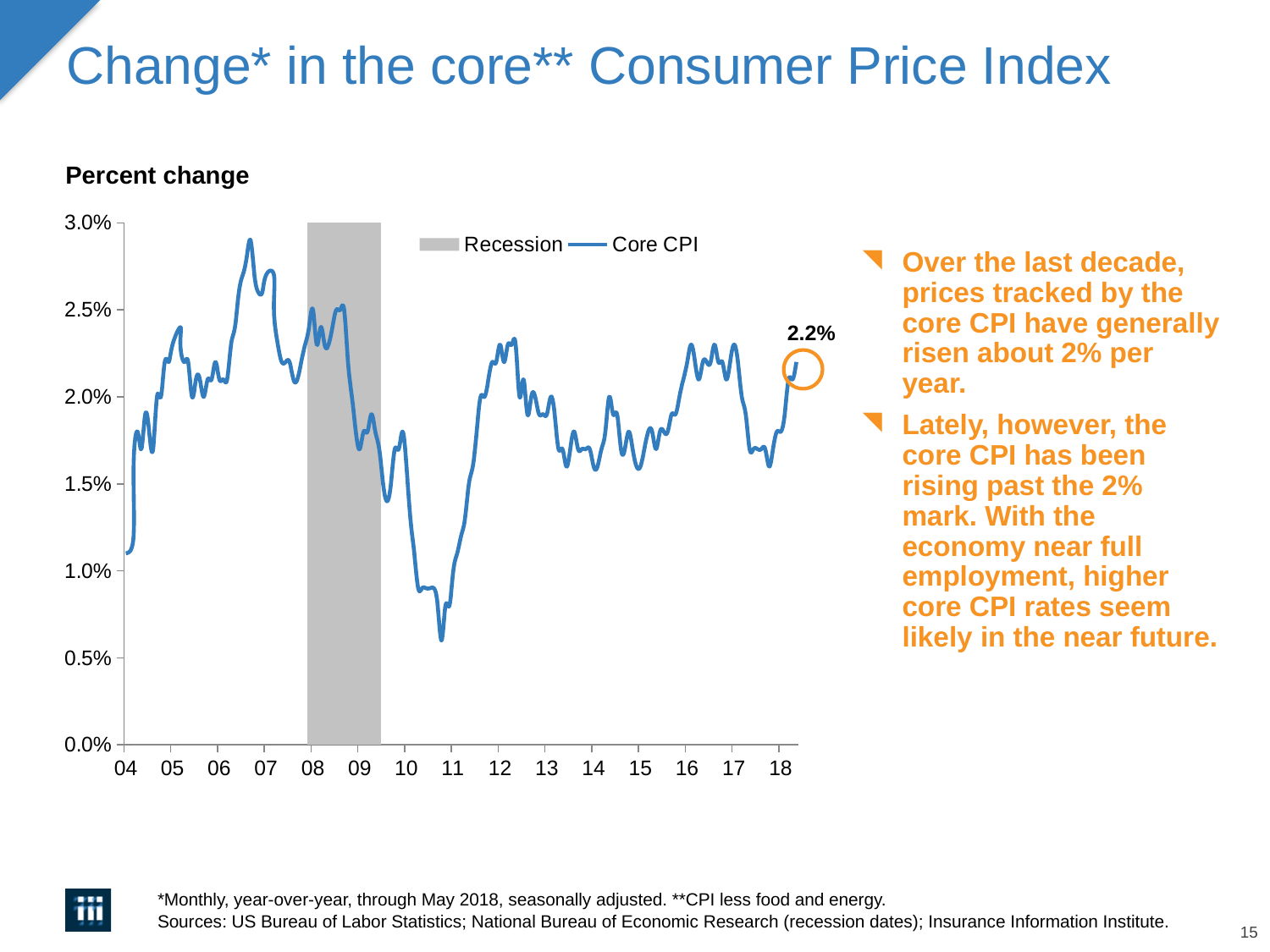
In which year does the core CPI line reach its highest point? 2006 Is the core CPI value at the lowest point of the line (late 2010) greater or less than 1.0%? less How many entries does the chart legend list? 2 In which year does the core CPI line reach its lowest point? 2010 What does the gray shaded area on the chart represent? Recession Is the core CPI value at its peak in 2006 greater or less than 2.5%? greater What is the labeled value of the core CPI at the end of the series (May 2018)? 2.2% Does the core CPI line rise or fall between the 2008 recession and 2010? fall How many year labels are shown on the x axis? 15 What kind of chart is shown on the slide? line chart Does the core CPI line rise or fall over the final months of the series leading up to the 2.2% label? rise Is the core CPI value at the start of 2004 greater or less than 1.5%? less